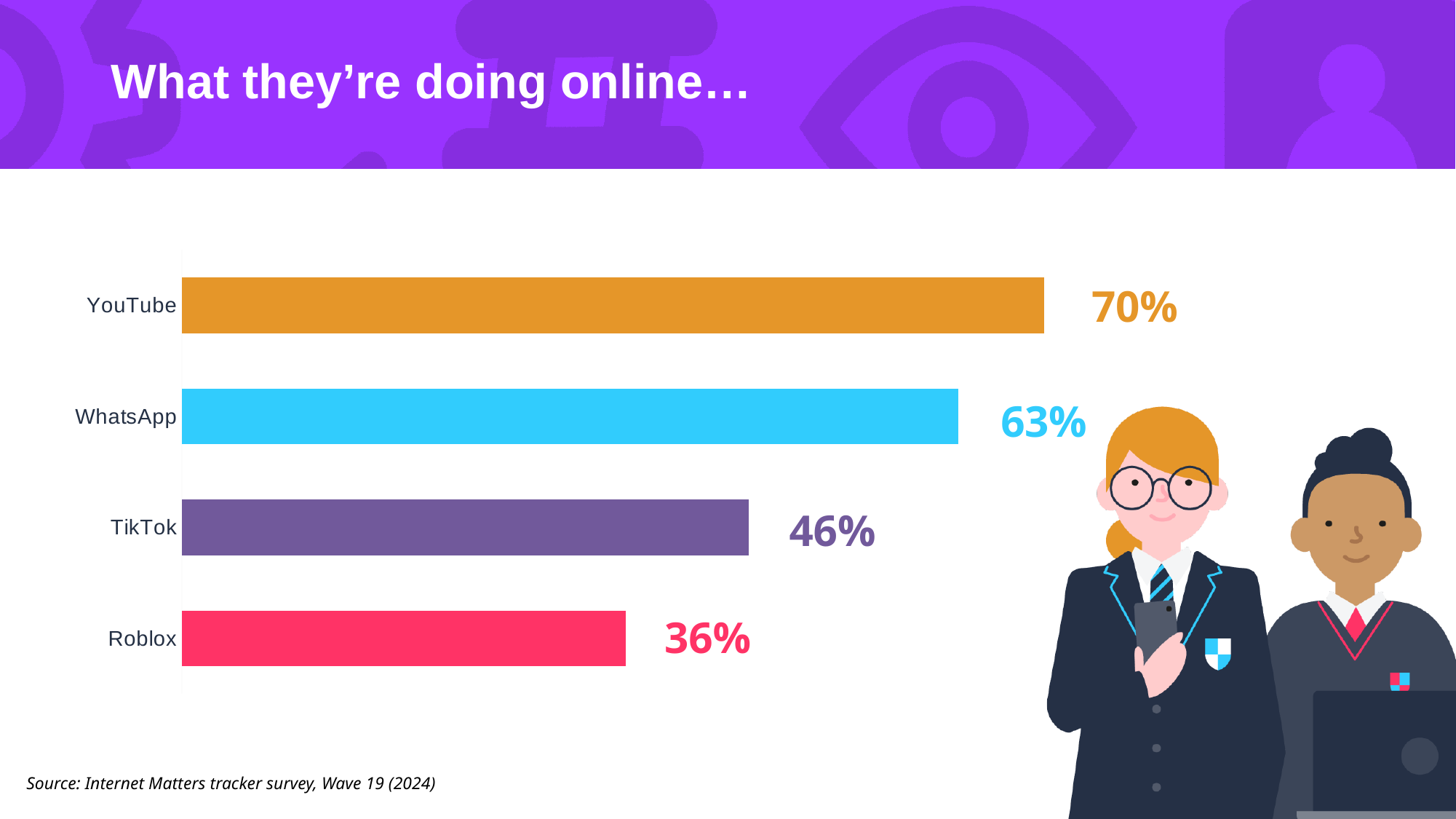
Which is larger, the value for WhatsApp or the value for TikTok? WhatsApp How many categories are shown in the chart? 4 What is the value for Roblox? 36% What is the value for WhatsApp? 63% What is the title of the slide containing the chart? What they're doing online… What is the difference between the values for TikTok and Roblox? 10% What is the value for YouTube? 70% Which category has the highest value? YouTube What is the value for TikTok? 46% What is the difference between the values for YouTube and WhatsApp? 7% What kind of chart is shown on the slide? Bar chart Which category has the lowest value? Roblox